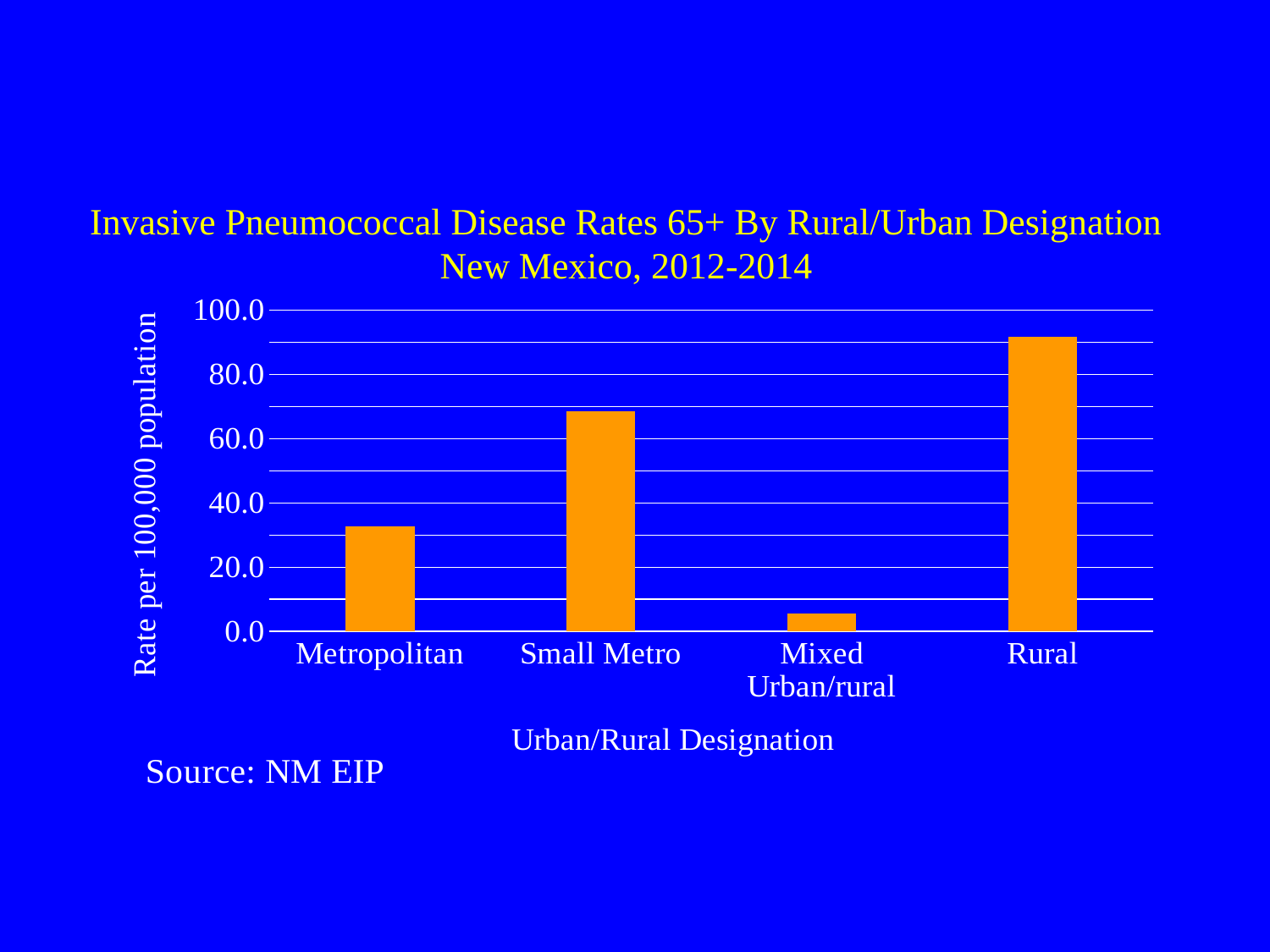
What is the label of the y axis? Rate per 100,000 population Is the value for Mixed Urban/rural greater or less than 20? less Is the value for Rural greater or less than 80? greater Is the value for Small Metro greater or less than 60? greater Which has a higher rate, Metropolitan or Small Metro? Small Metro What is the label of the x axis? Urban/Rural Designation How many categories are shown on the x axis of the chart? 4 Which category has the highest rate in the chart? Rural Which category has the lowest rate in the chart? Mixed Urban/rural What kind of chart is shown on the slide? Bar chart Which has a higher rate, Rural or Small Metro? Rural